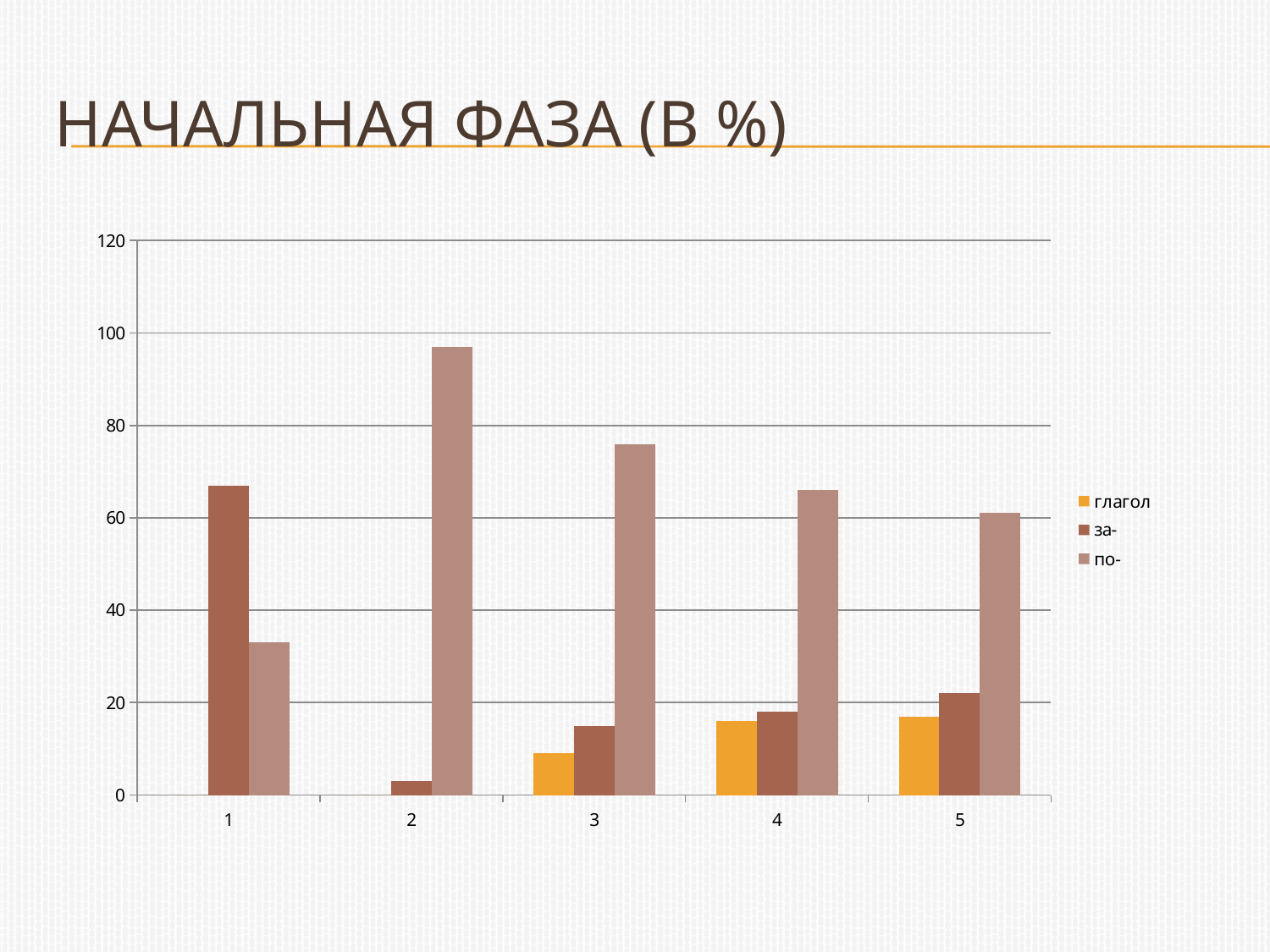
Is the value of "по-" for category 2 greater or less than 80? greater For category 1, which series has the larger value, "за-" or "по-"? за- For which category is the value of the "по-" series highest? 2 Is the value of "за-" for category 1 greater or less than 60? greater For which category is the value of the "за-" series lowest? 2 What kind of chart is shown on the slide? bar chart What is the title of the slide? НАЧАЛЬНАЯ ФАЗА (В %) Does the value of the "по-" series rise or fall from category 2 to category 5? fall For which category is the value of the "за-" series highest? 1 How many series does the legend list? 3 For which category is the value of the "по-" series lowest? 1 How many categories are shown on the x axis? 5